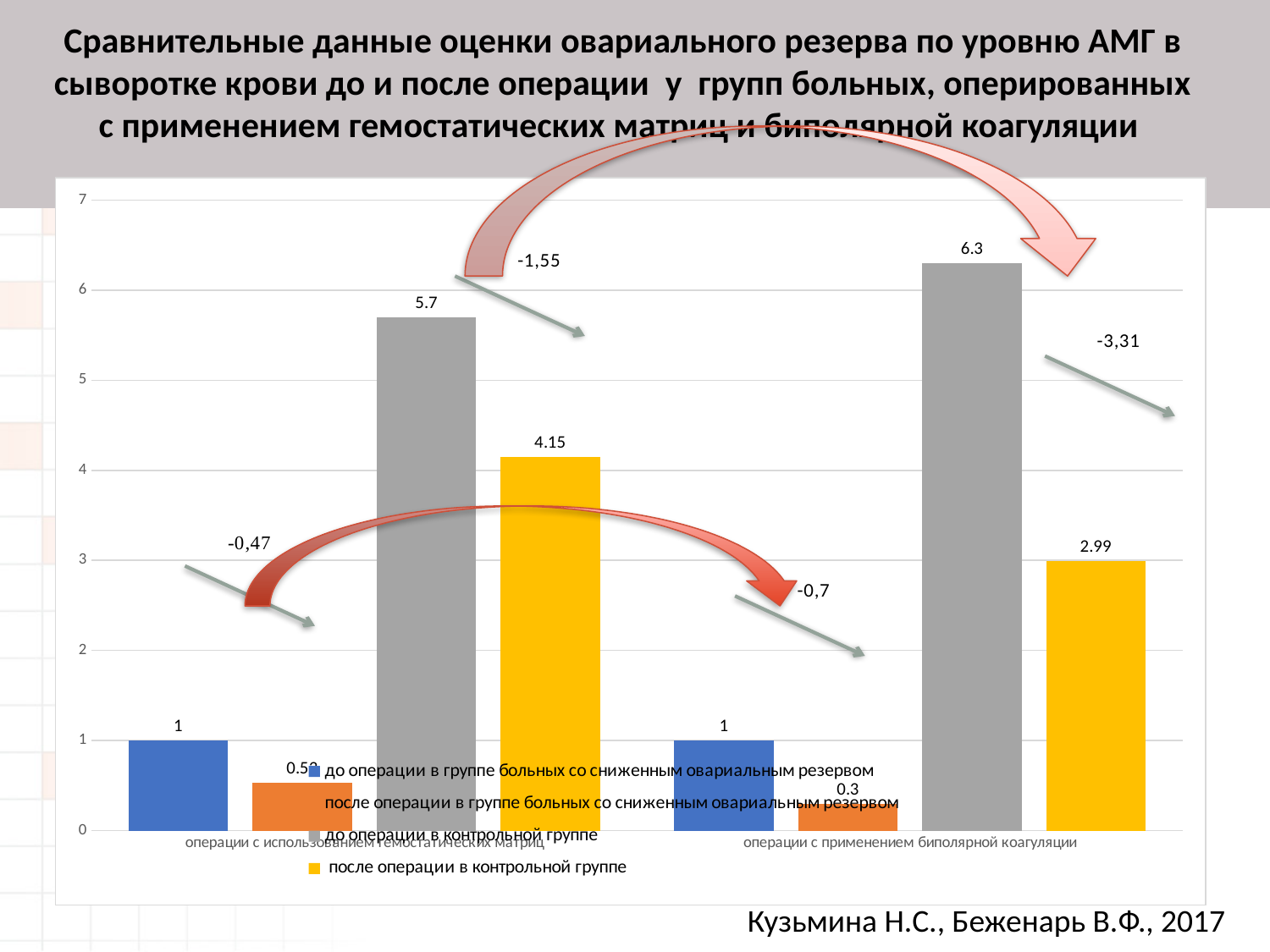
What is the value for 'до операции в контрольной группе' in the category 'операции с применением биполярной коагуляции'? 6.3 What is the value for 'после операции в контрольной группе' in the category 'операции с применением биполярной коагуляции'? 2.99 How many series does the legend list? 4 Which series has the lowest value in the category 'операции с применением биполярной коагуляции'? после операции в группе больных со сниженным овариальным резервом Which series has the highest value in the category 'операции с применением биполярной коагуляции'? до операции в контрольной группе Which is larger: the 'после операции в контрольной группе' value for 'операции с использованием гемостатических матриц' or for 'операции с применением биполярной коагуляции'? операции с использованием гемостатических матриц What is the value for 'после операции в группе больных со сниженным овариальным резервом' in the category 'операции с применением биполярной коагуляции'? 0.3 What type of chart is shown on the slide? bar chart What is the difference between the 'до операции в контрольной группе' and 'после операции в контрольной группе' values in the category 'операции с применением биполярной коагуляции'? 3.31 What is the value for 'после операции в контрольной группе' in the category 'операции с использованием гемостатических матриц'? 4.15 How many categories are shown on the x axis? 2 What is the value for 'до операции в контрольной группе' in the category 'операции с использованием гемостатических матриц'? 5.7